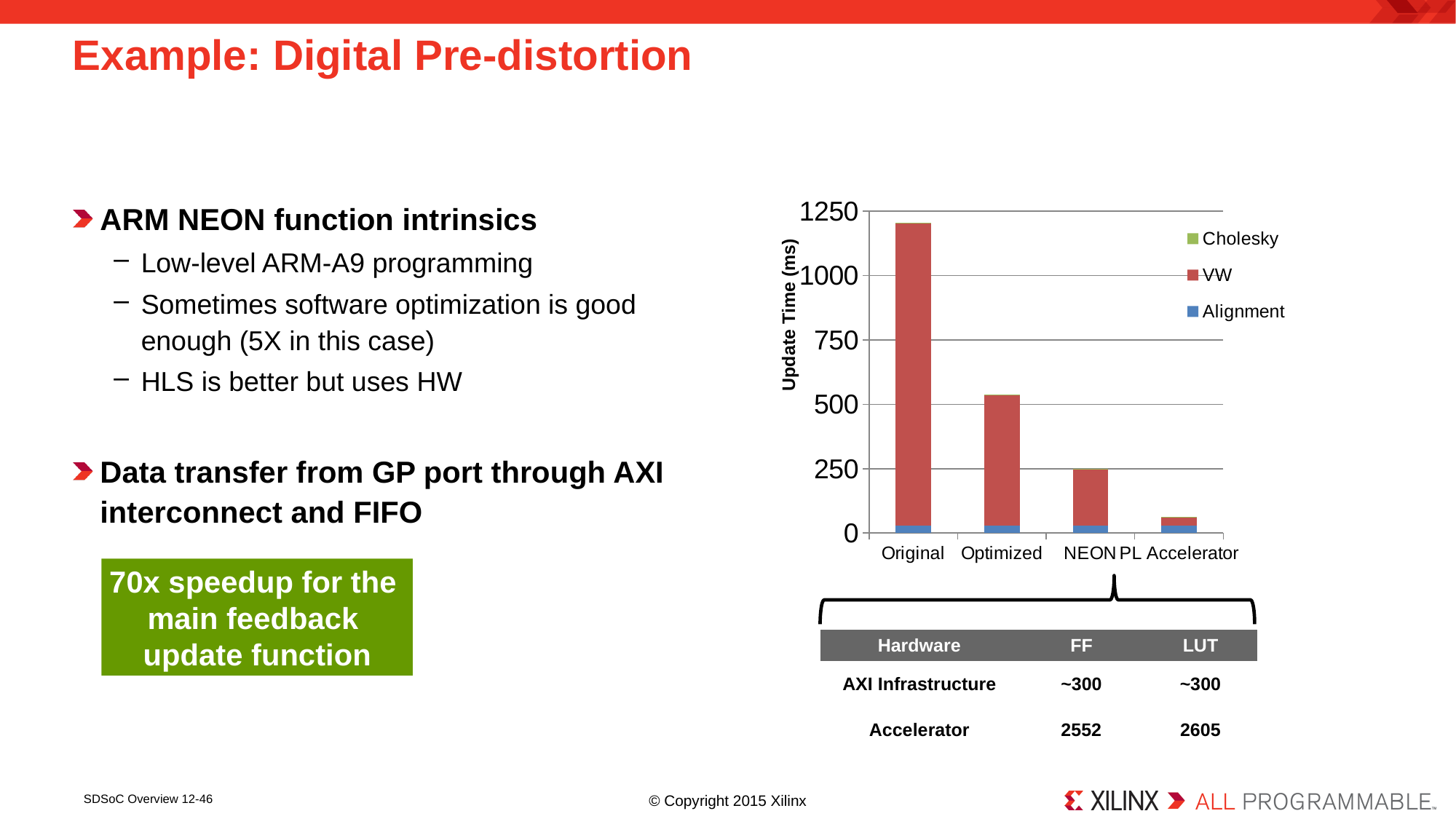
How many series does the chart's legend list? 3 Which category has the highest total update time? Original Is the total update time for Original greater or less than 1000? greater Which category has the lowest total update time? PL Accelerator Do the total update times rise or fall moving from Original to PL Accelerator along the x axis? fall Which series in the legend is shown in blue? Alignment What is the label of the chart's vertical axis? Update Time (ms) What kind of chart is shown on the slide? bar chart Is the total update time for PL Accelerator greater or less than 250? less Which has a larger total update time, Optimized or NEON? Optimized How many categories are shown on the x axis of the chart? 4 Is the total update time for Optimized greater or less than 500? greater